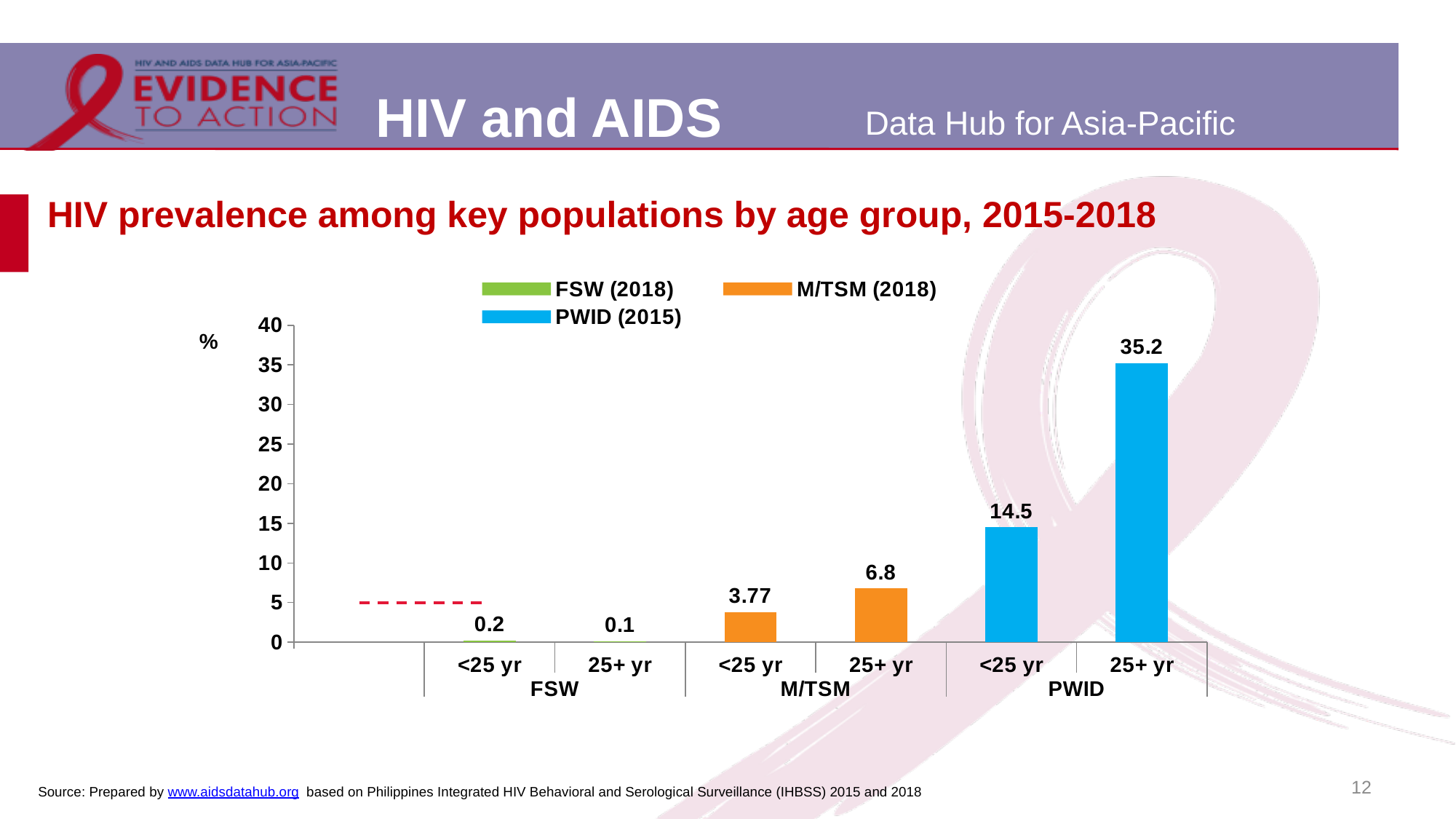
What is the difference in HIV prevalence between PWID aged 25+ yr and PWID aged <25 yr? 20.7 How many series does the legend list? 3 Which group and age category has the highest HIV prevalence? PWID 25+ yr What is the HIV prevalence for M/TSM aged <25 yr? 3.77 What type of chart is shown on the slide? Bar chart How many bars (age-group categories) are plotted in the chart? 6 Which group and age category has the lowest HIV prevalence? FSW 25+ yr What is the HIV prevalence for PWID aged 25+ yr? 35.2 What is the HIV prevalence for FSW aged 25+ yr? 0.1 Which is larger: HIV prevalence for M/TSM aged 25+ yr or PWID aged <25 yr? PWID <25 yr What is the HIV prevalence for PWID aged <25 yr? 14.5 What is the difference in HIV prevalence between M/TSM aged 25+ yr and M/TSM aged <25 yr? 3.03